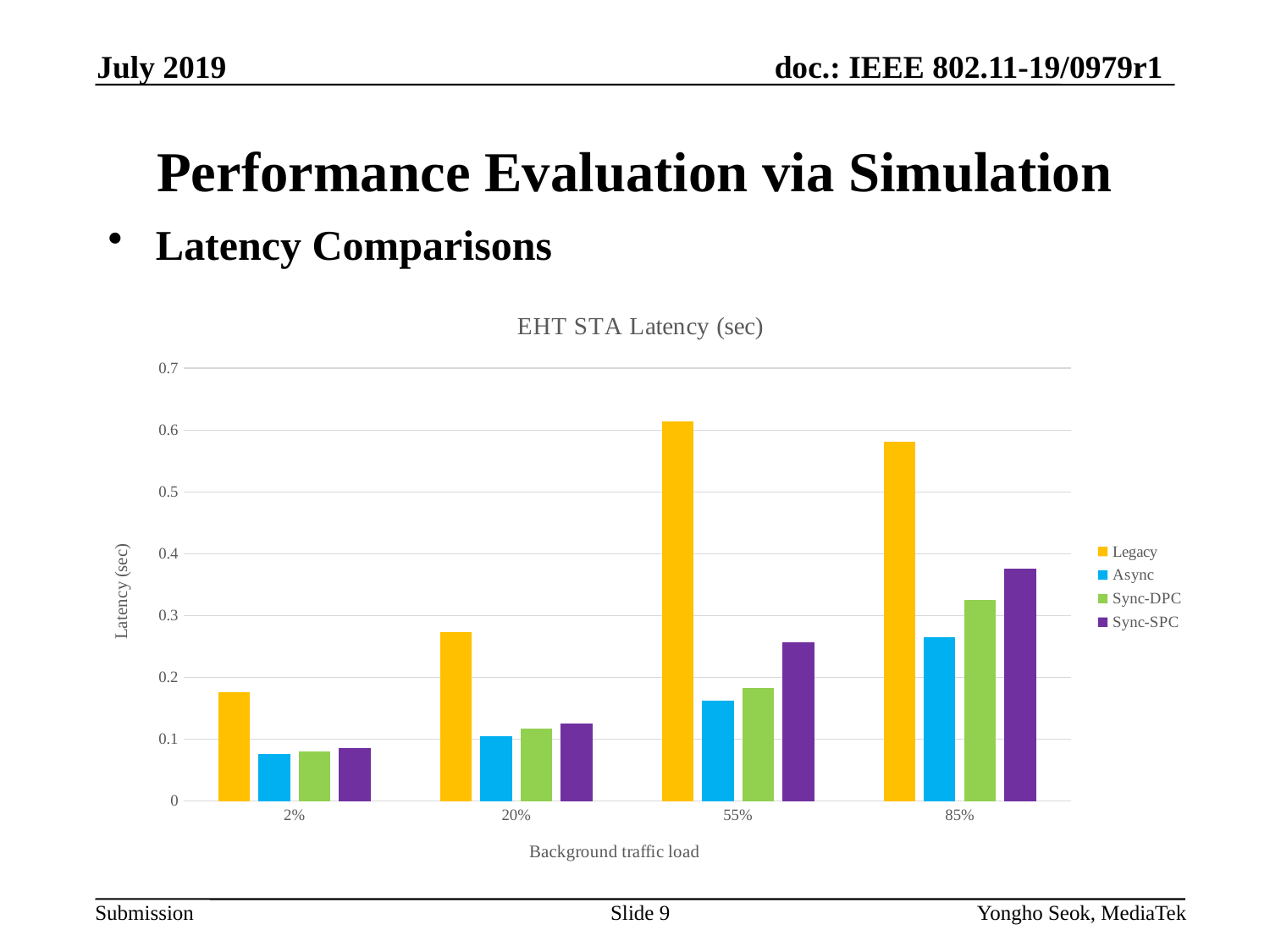
What is the title of the chart? EHT STA Latency (sec) How many series does the legend list? 4 Is the Async latency at 2% background traffic load greater or less than 0.1? less Does the Async latency rise or fall as the background traffic load increases from 2% to 85%? rise How many background traffic load categories are shown on the x axis? 4 Is the Legacy latency at 55% background traffic load greater or less than 0.5? greater At which background traffic load does the Legacy series reach its highest latency? 55% What is the label of the x axis? Background traffic load What kind of chart is shown on the slide? bar chart Which series has the highest latency at the 55% background traffic load? Legacy Is the Sync-SPC latency at 85% background traffic load greater or less than 0.3? greater Which is larger at 85% background traffic load, the Sync-DPC latency or the Sync-SPC latency? Sync-SPC